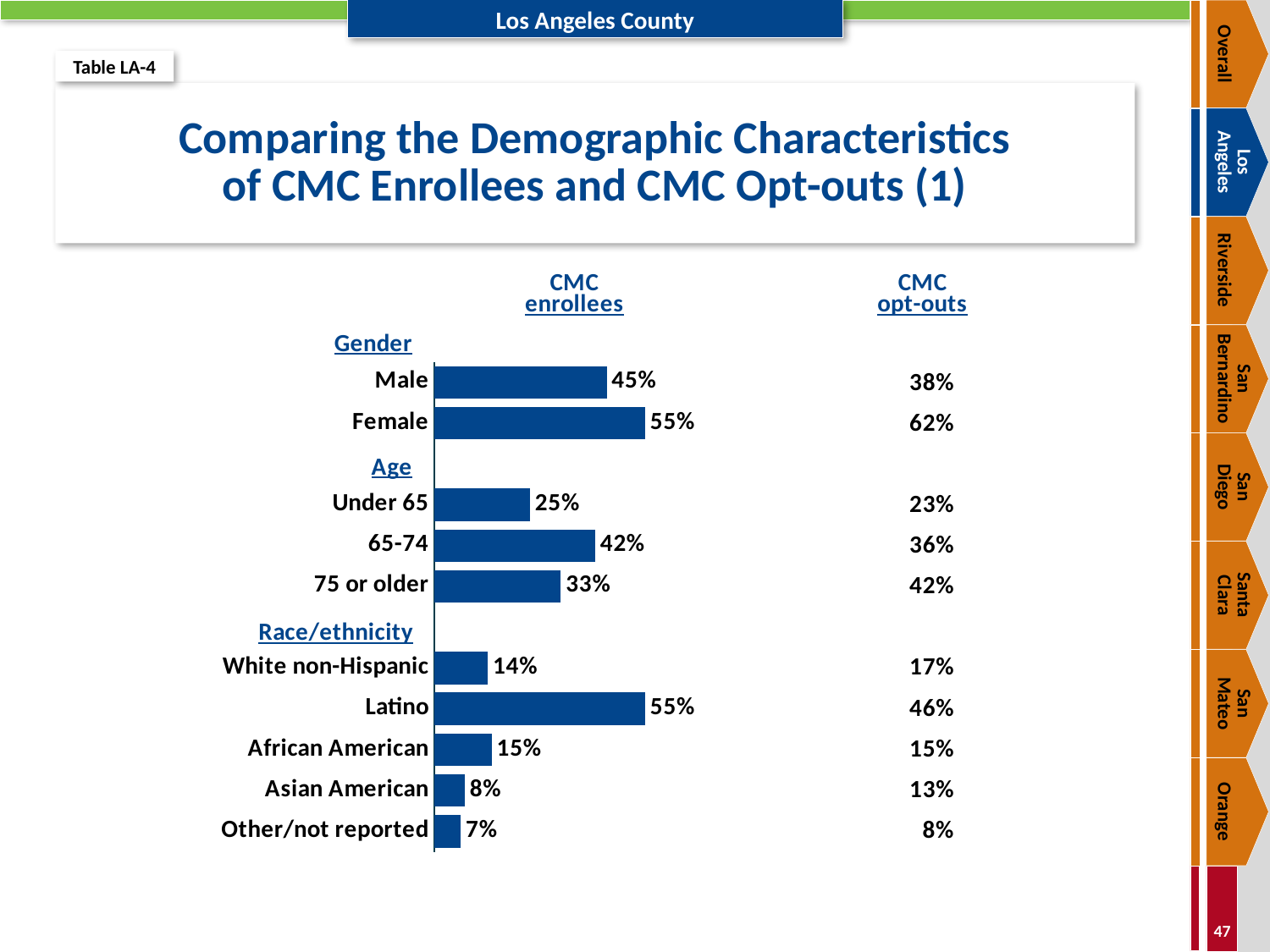
Which is larger for CMC enrollees: Under 65 or 75 or older? 75 or older What is the difference between the Female and Male CMC enrollees percentages? 10% What percentage of CMC opt-outs are 75 or older? 42% Among the Race/ethnicity categories, which has the highest CMC enrollees bar? Latino What percentage of CMC enrollees are Male? 45% How many bars are plotted in the CMC enrollees chart? 10 What kind of chart is used to show the CMC enrollees values? bar chart What percentage of CMC enrollees are Asian American? 8% Which category has the lowest CMC enrollees bar? Other/not reported What is the difference between the Latino and White non-Hispanic CMC enrollees percentages? 41% What percentage of CMC enrollees are 75 or older? 33% Among the Age categories, which has the highest CMC enrollees bar? 65-74